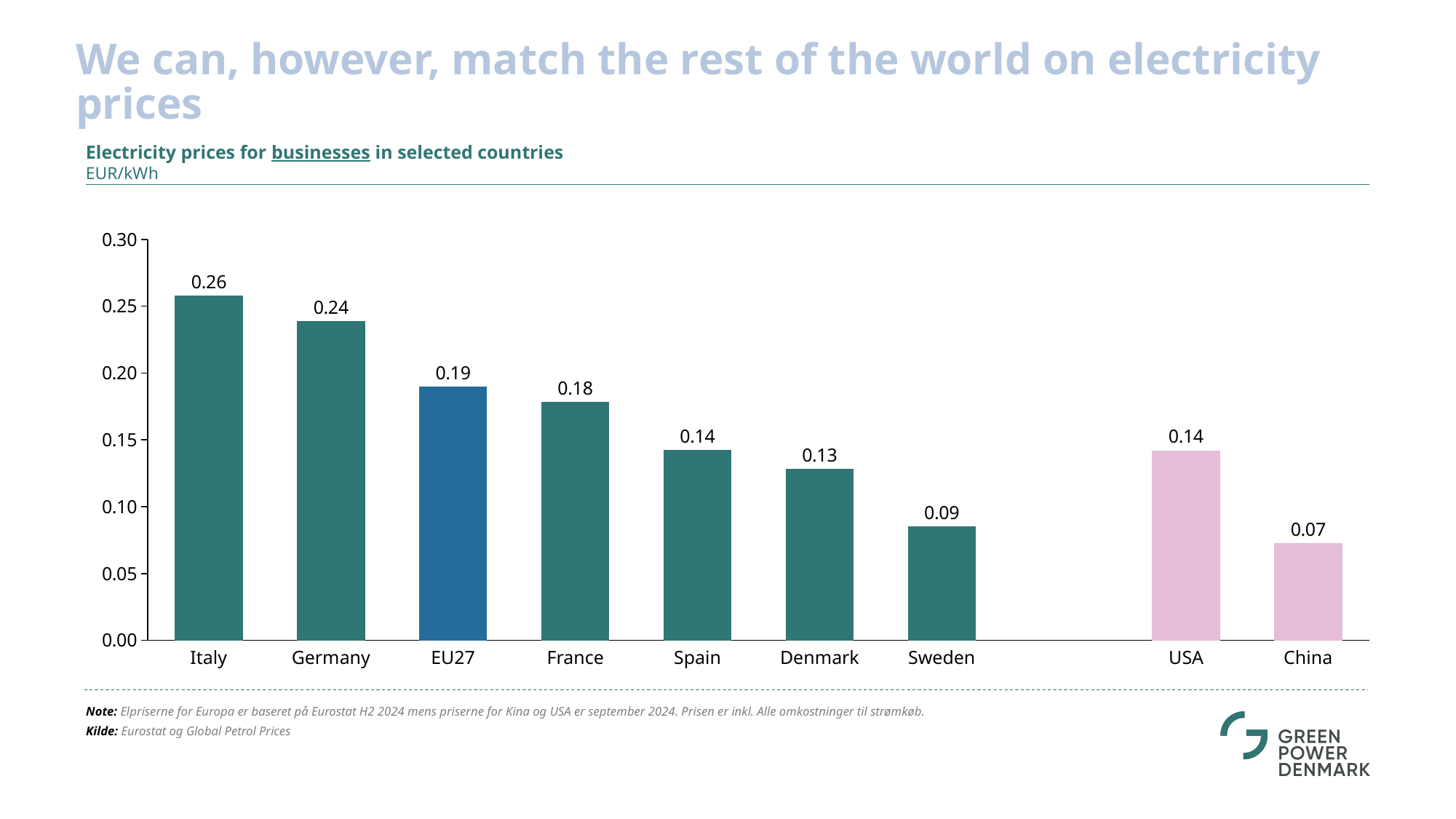
What is the difference between the electricity prices for Germany and Sweden? 0.15 What is the value shown for EU27? 0.19 What is the electricity price for businesses in Denmark? 0.13 Which country has the lowest electricity price for businesses? China What is the electricity price for businesses in Italy? 0.26 Is the value for Sweden greater or less than 0.10? less What kind of chart is shown on the slide? Bar chart Which country has the highest electricity price for businesses? Italy What is the electricity price for businesses in China? 0.07 Which has a higher electricity price for businesses, France or Spain? France How many countries or regions are shown in the chart? 9 What unit is used for the values in the chart? EUR/kWh